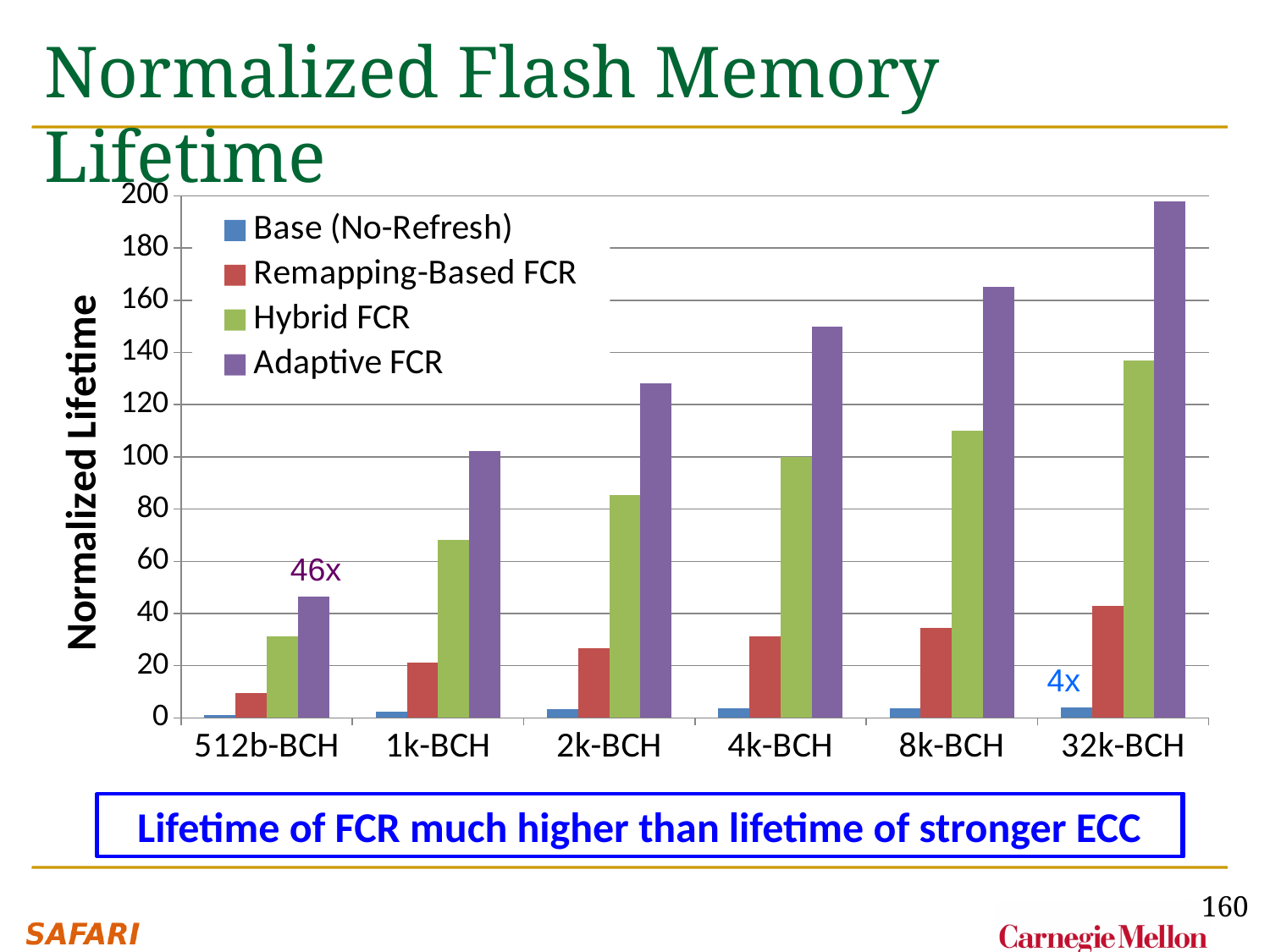
Is the Adaptive FCR value for 32k-BCH greater or less than 180? greater How many ECC configurations (categories) are shown on the x axis? 6 What is the label on the y axis of the chart? Normalized Lifetime Is the Remapping-Based FCR value for 2k-BCH greater or less than 40? less How many series does the legend list? 4 Which series has the lowest bars in every category? Base (No-Refresh) Is the Adaptive FCR value for 8k-BCH greater or less than 160? greater Do the Adaptive FCR values rise or fall as you move from 512b-BCH to 32k-BCH? rise What kind of chart is shown on the slide? bar chart Which category has the highest Adaptive FCR bar? 32k-BCH For 8k-BCH, which is larger: the Hybrid FCR value or the Remapping-Based FCR value? Hybrid FCR